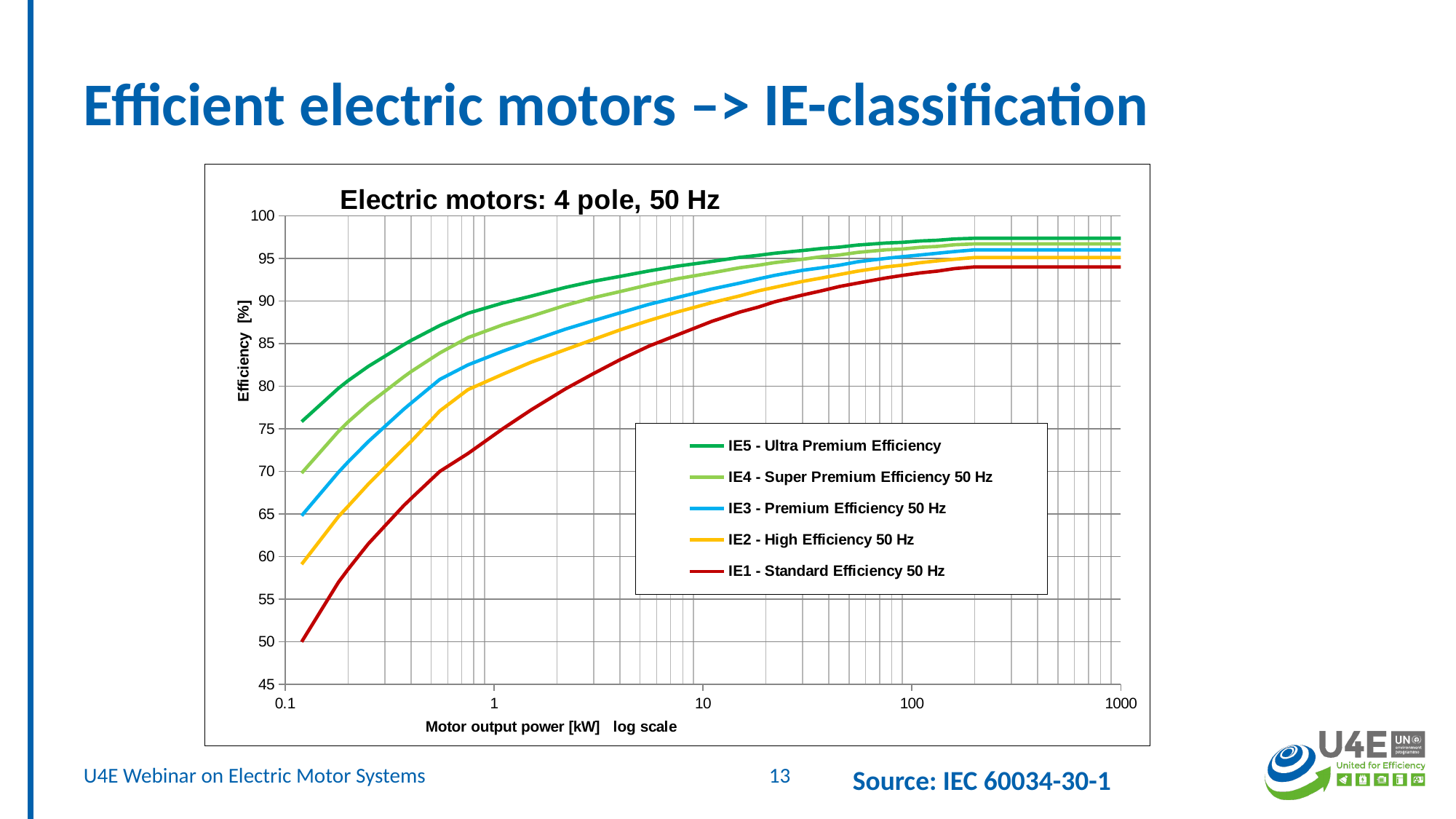
How many series does the legend list? 5 Is the efficiency of IE5 - Ultra Premium Efficiency at 100 kW greater or less than 95? greater What is the title of the chart? Electric motors: 4 pole, 50 Hz What kind of chart is shown on the slide? Line chart Which series has the lowest efficiency across the motor output power range? IE1 - Standard Efficiency 50 Hz At 1 kW, which series has the higher efficiency: IE5 - Ultra Premium Efficiency or IE1 - Standard Efficiency 50 Hz? IE5 - Ultra Premium Efficiency Does the efficiency of the IE1 - Standard Efficiency 50 Hz series rise or fall as motor output power increases from 0.1 kW to 100 kW? Rise Which series has the highest efficiency across the motor output power range? IE5 - Ultra Premium Efficiency Is the efficiency of IE1 - Standard Efficiency 50 Hz at 1000 kW greater or less than 95? less Is the efficiency of IE1 - Standard Efficiency 50 Hz at 1 kW greater or less than 70? greater What is the label of the x axis? Motor output power [kW] log scale